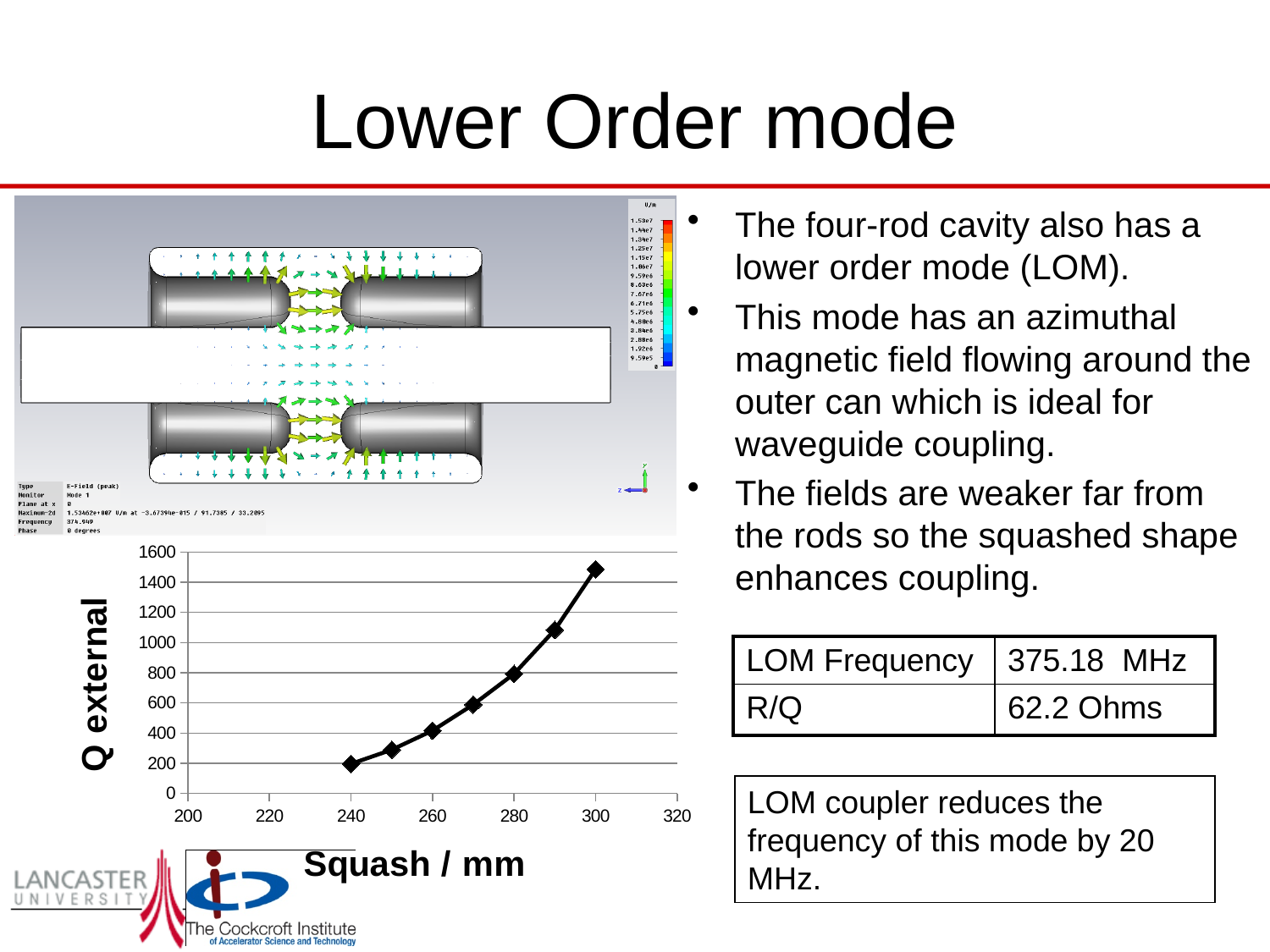
What is the label on the x axis of the chart? Squash / mm What is the label on the y axis of the chart? Q external What kind of chart is shown on the slide? line chart At which Squash value is Q external highest? 300 How many data points are plotted on the Q external chart? 7 Is the Q external value at a Squash of 260 mm greater or less than 600? less Which has the larger Q external: a Squash of 300 mm or 240 mm? 300 mm Is the Q external value at a Squash of 300 mm greater or less than 1400? greater Does Q external rise or fall as Squash increases along the x axis? rise Is the Q external value at a Squash of 240 mm greater or less than 400? less At which Squash value is Q external lowest? 240